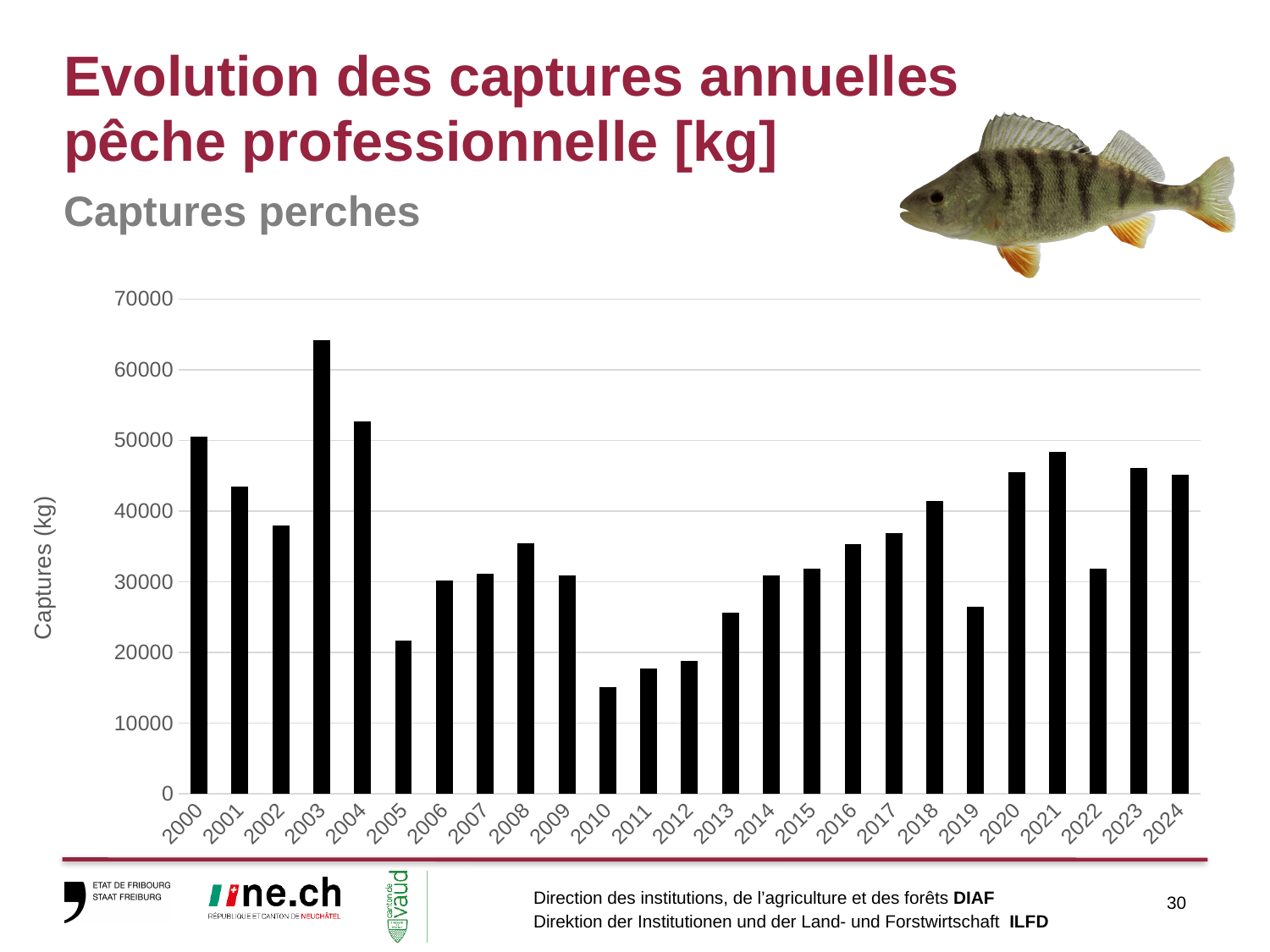
Which year has the lowest catch value on the chart? 2010 Is the value for 2018 greater or less than 40000? greater Is the value for 2010 greater or less than 20000? less How many years (bars) are plotted on the chart? 25 Is the value for 2003 greater or less than 60000? greater Which year has the highest catch value on the chart? 2003 Do the values generally rise or fall from 2010 to 2018? rise Which year has the larger value, 2003 or 2004? 2003 What kind of chart is shown on the slide? bar chart What is the label on the vertical axis of the chart? Captures (kg) Which year has the larger value, 2020 or 2021? 2021